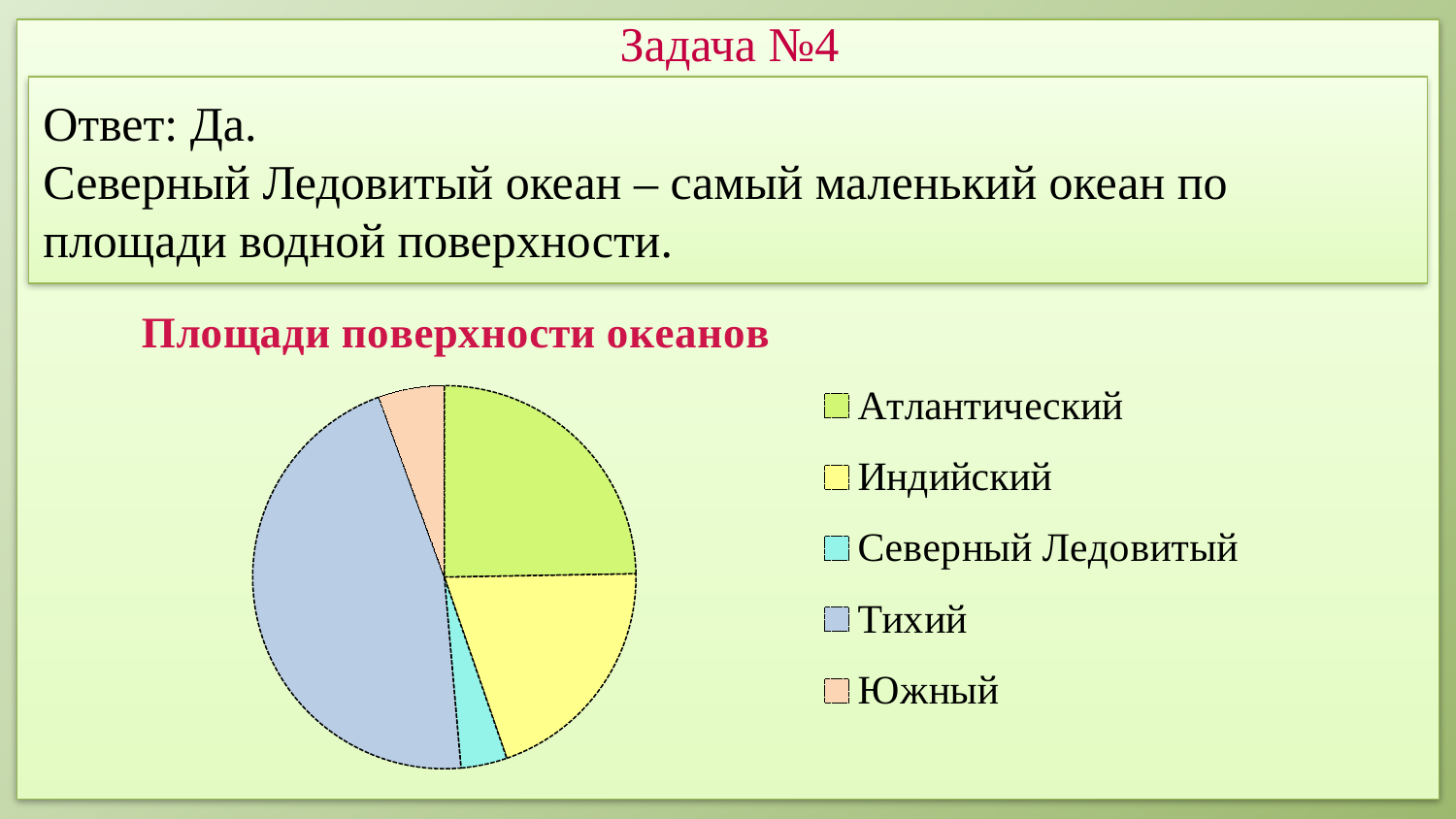
Which ocean has the smallest slice in the pie chart? Северный Ледовитый Which slice is larger, Атлантический or Южный? Атлантический Which slice is larger, Индийский or Южный? Индийский What is the title of the pie chart? Площади поверхности океанов Which slice is larger, Тихий or Атлантический? Тихий What kind of chart is shown on the slide? pie chart How many slices does the pie chart have? 5 How many entries does the legend of the pie chart list? 5 Which ocean has the largest slice in the pie chart? Тихий Which ocean is shown in the blue slice of the pie chart? Тихий